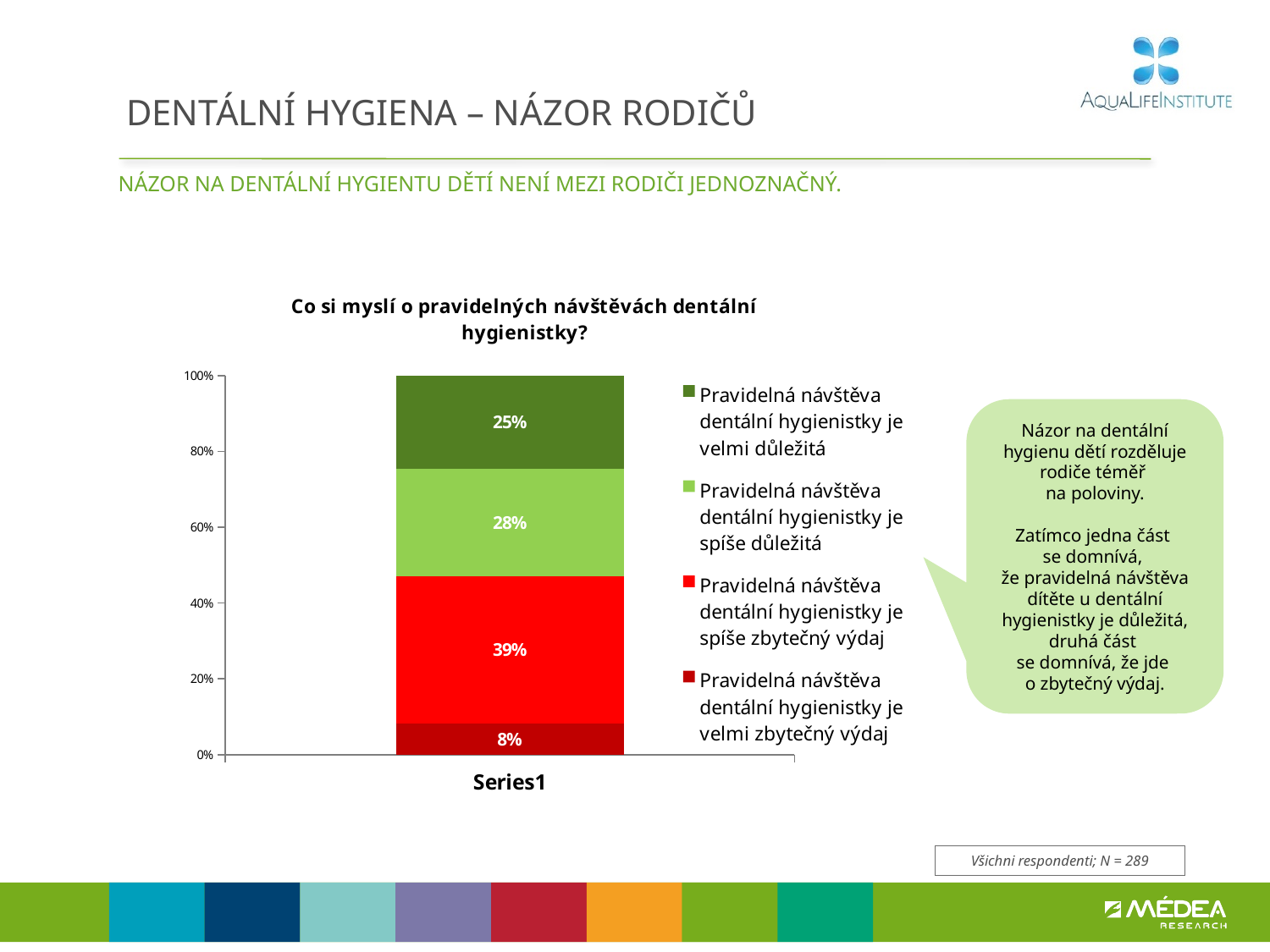
What is the value for "Pravidelná návštěva dentální hygienistky je spíše důležitá"? 28% What is the value for "Pravidelná návštěva dentální hygienistky je velmi zbytečný výdaj"? 8% What is the difference between the "spíše zbytečný výdaj" value and the "velmi důležitá" value? 14% What is the value for "Pravidelná návštěva dentální hygienistky je velmi důležitá"? 25% Which is larger: the value for "spíše důležitá" or the value for "velmi důležitá"? spíše důležitá Which series has the lowest value in the stacked bar? Pravidelná návštěva dentální hygienistky je velmi zbytečný výdaj What is the total of the stacked bar labelled Series1? 100% What is the value for "Pravidelná návštěva dentální hygienistky je spíše zbytečný výdaj"? 39% What kind of chart is shown on the slide? stacked bar chart Which series has the highest value in the stacked bar? Pravidelná návštěva dentální hygienistky je spíše zbytečný výdaj How many series does the legend list? 4 What is the chart's title? Co si myslí o pravidelných návštěvách dentální hygienistky?